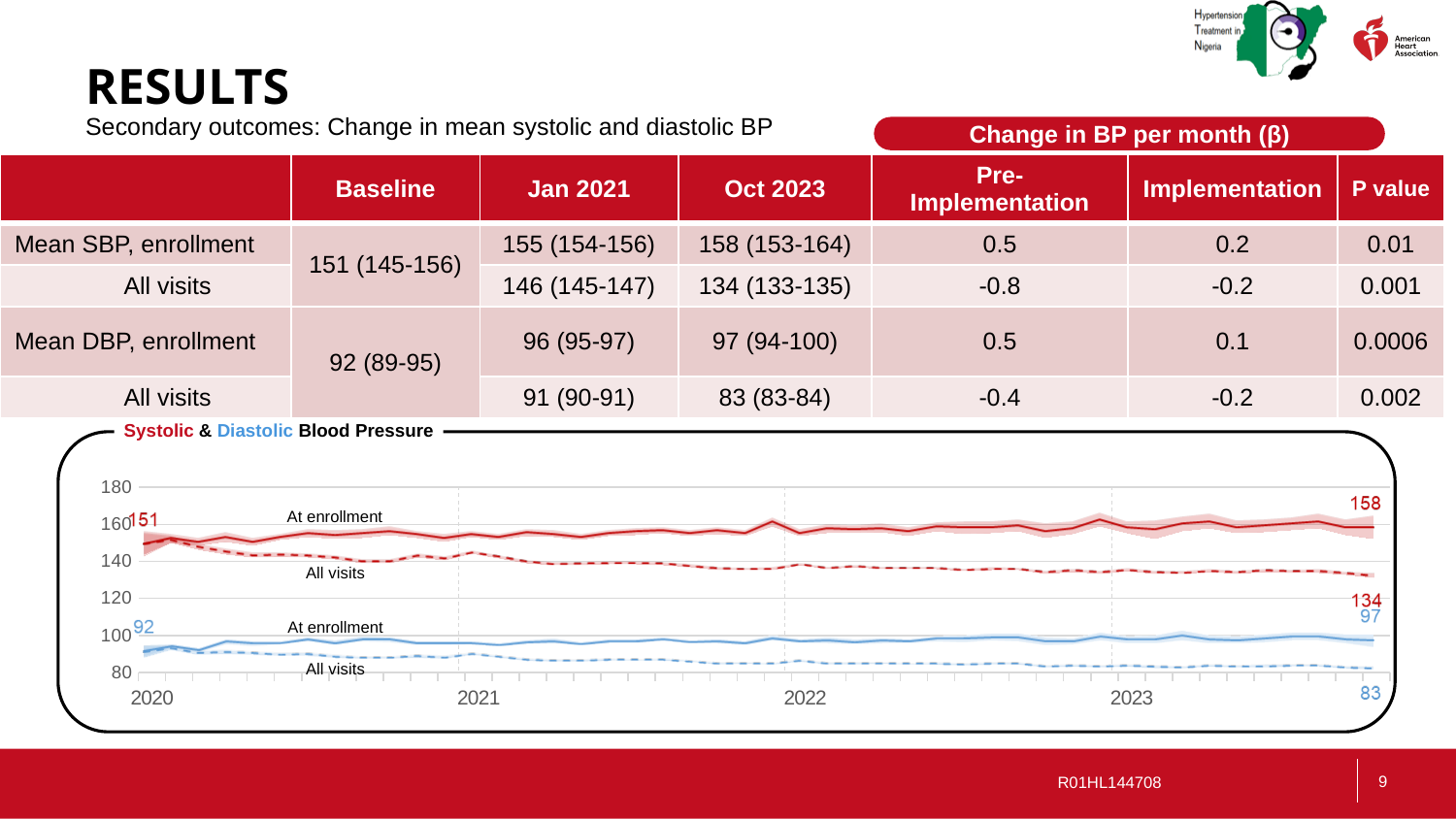
What is the final value of the systolic 'All visits' line at the right end of the chart? 134 What is the starting value of the diastolic blood pressure line in 2020? 92 What is the difference between the final diastolic 'At enrollment' value and the final diastolic 'All visits' value? 14 What kind of chart is shown on the slide? line chart What is the final value of the systolic 'At enrollment' line at the right end of the chart? 158 Does the systolic 'All visits' line rise or fall from 2020 to the end of the chart? fall Is the final systolic 'At enrollment' value greater or less than 140? greater Which colour is used for the diastolic blood pressure lines? blue What is the difference between the final systolic 'At enrollment' value and the final systolic 'All visits' value? 24 What is the final value of the diastolic 'At enrollment' line at the right end of the chart? 97 What is the final value of the diastolic 'All visits' line at the right end of the chart? 83 What is the starting value of the systolic blood pressure line in 2020? 151